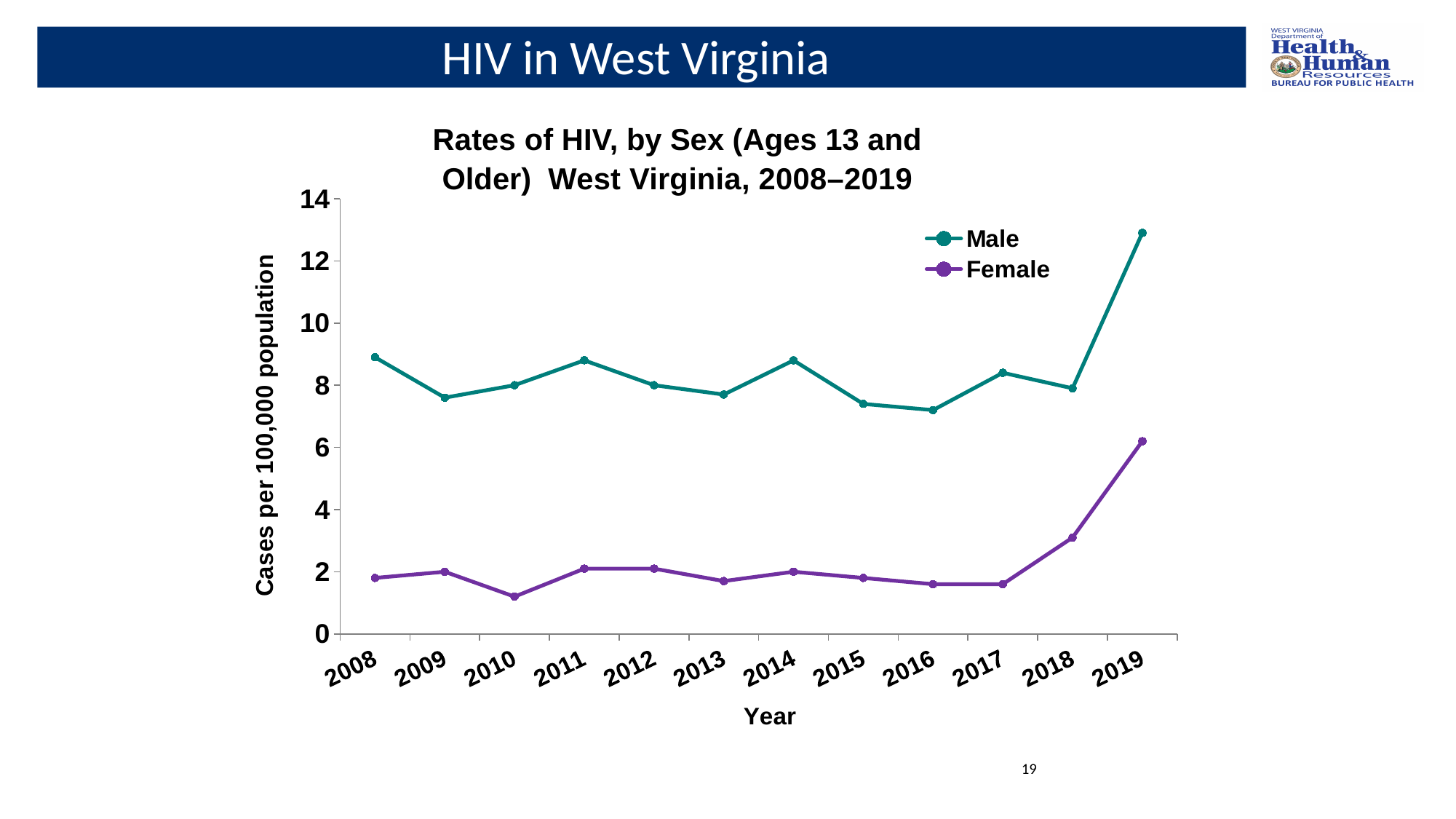
Is the Female value for 2018 greater or less than 2? greater What is the label on the y axis? Cases per 100,000 population How many series does the legend list? 2 What kind of chart is shown on the slide? line chart Do the Female rates rise or fall from 2017 to 2019? rise In which year is the Male rate highest? 2019 Is the Female value for 2019 greater or less than 4? greater In which year is the Female rate lowest? 2010 Which series has the higher rate in 2019, Male or Female? Male Is the Male value for 2008 greater or less than 10? less How many years are plotted along the x axis? 12